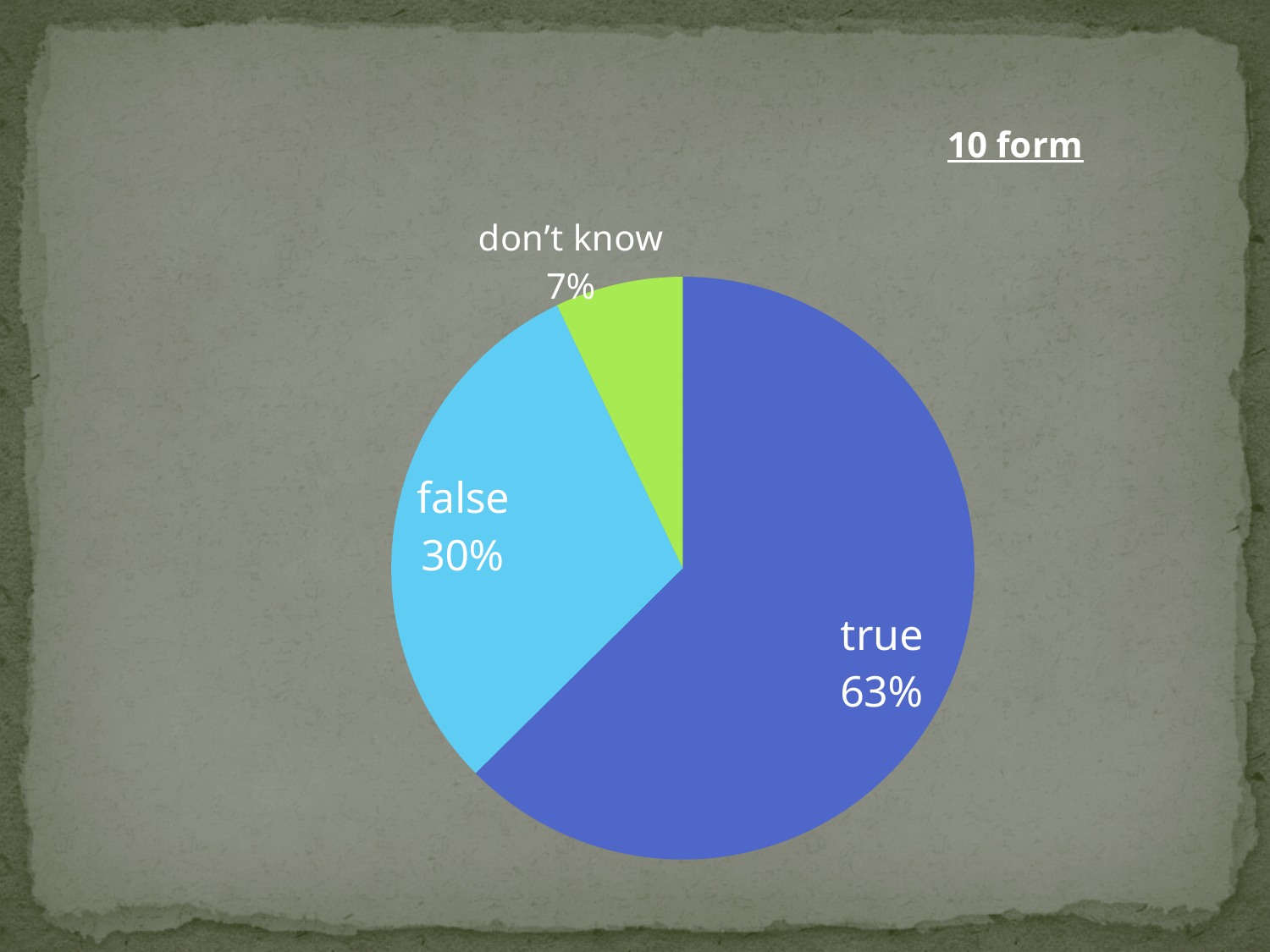
What is the heading shown above the chart on the slide? 10 form Which is larger, the "false" slice or the "don't know" slice? false What share of the pie does the "false" slice represent? 30% Which slice of the pie is the largest? true What share of the pie does the "don't know" slice represent? 7% What is the difference in percentage points between the "true" and "false" slices? 33 What share of the pie does the "true" slice represent? 63% What kind of chart is shown on the slide? pie chart What is the difference in percentage points between the "false" and "don't know" slices? 23 What colour is the "don't know" slice? green How many slices does the pie chart have? 3 Which slice of the pie is the smallest? don't know